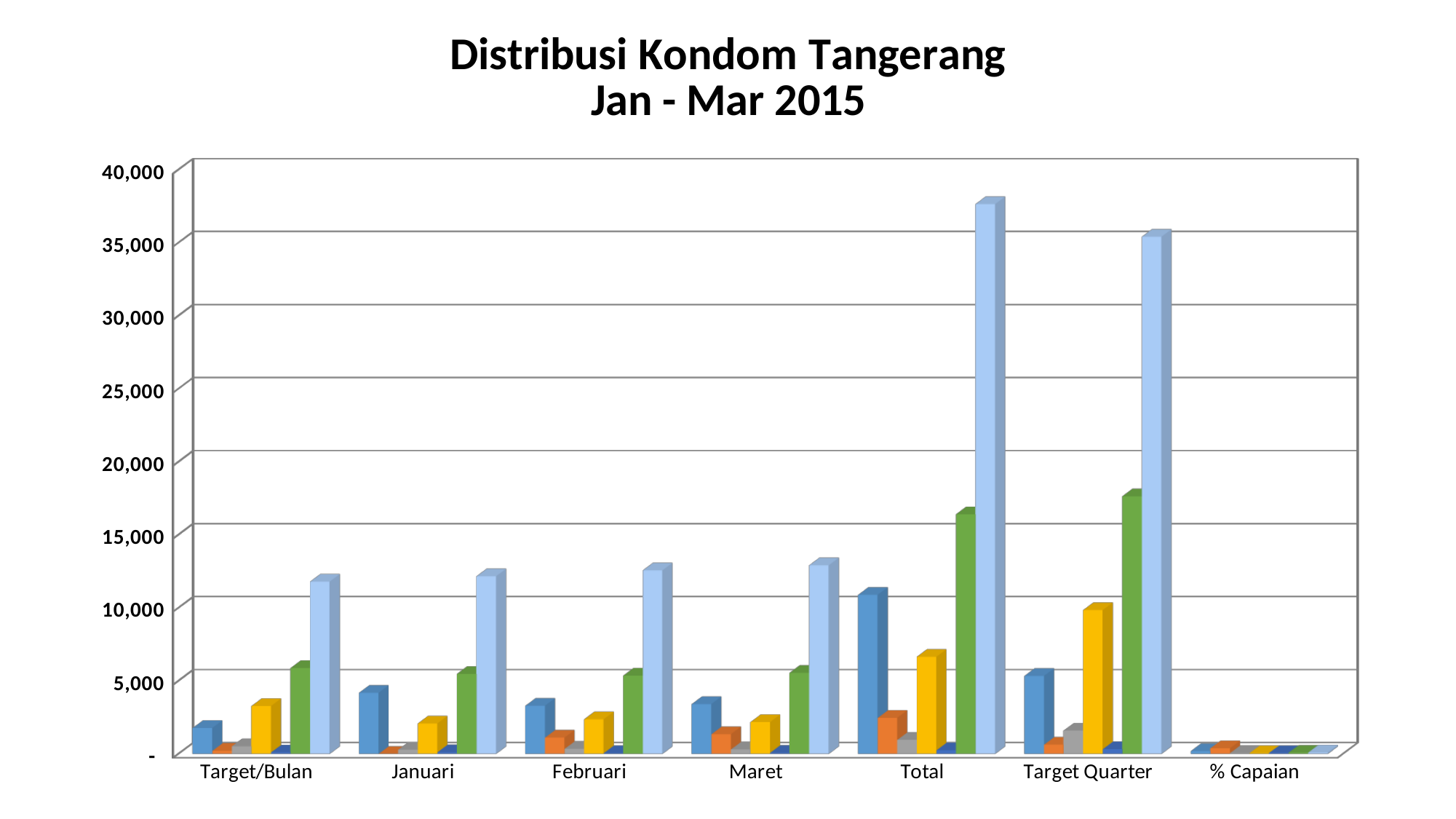
Which is larger for the Total category: the light blue bar or the green bar? the light blue bar Which category contains the tallest bar in the chart? Total Is the value of the light blue bar for Total greater or less than 35,000? greater Is the value of the yellow bar for Target/Bulan greater or less than 5,000? less Is the value of the blue bar for Januari greater or less than 5,000? less What type of chart is shown on the slide? bar chart Which is larger: the blue bar for Total or the blue bar for Target Quarter? the blue bar for Total How many categories are shown on the x axis? 7 What is the title of the chart? Distribusi Kondom Tangerang Jan - Mar 2015 Which category has the smallest bars overall? % Capaian